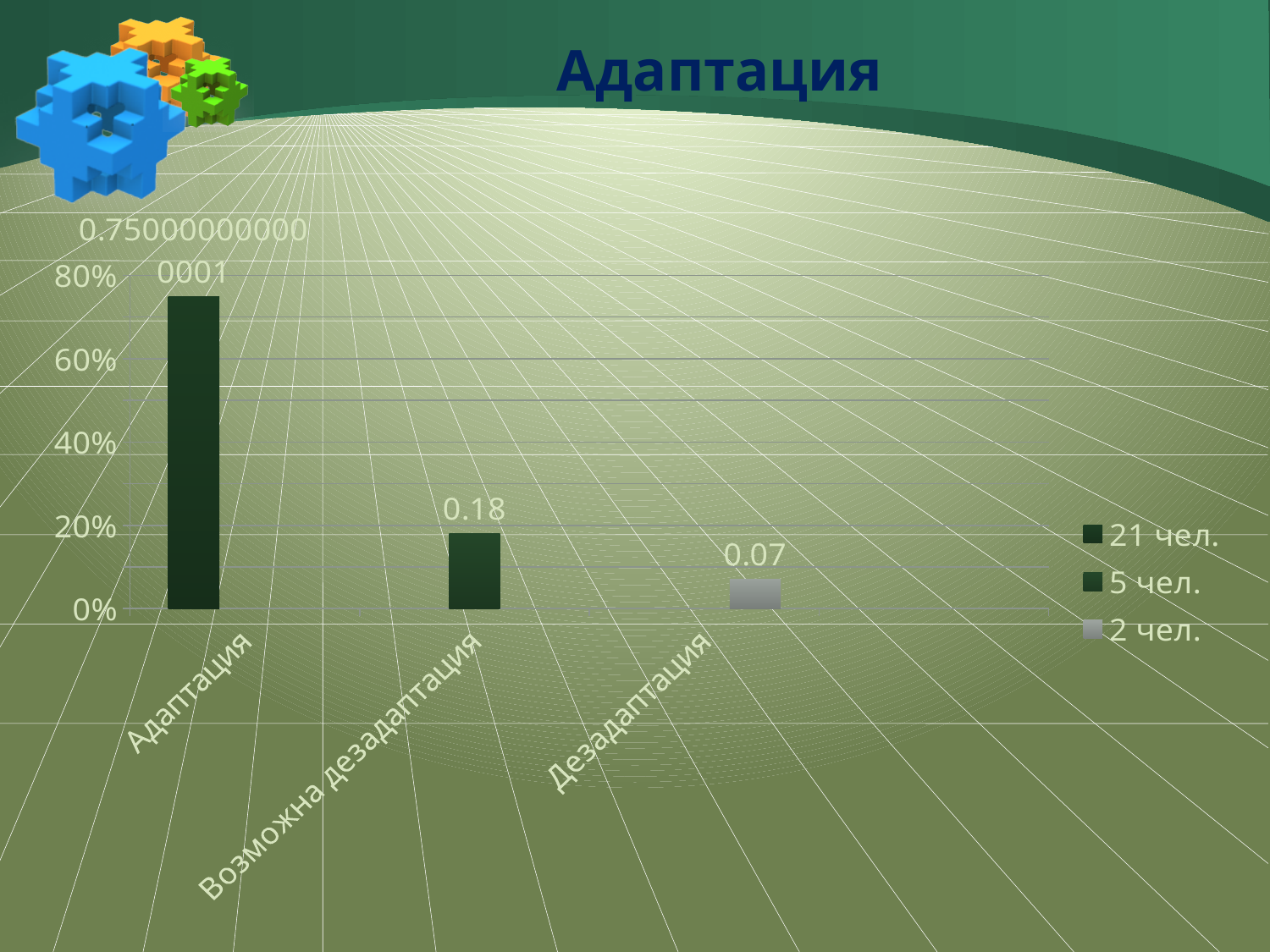
Which category has the highest bar? Адаптация How many entries does the chart's legend list? 3 Do the bar values rise or fall from left to right along the x axis? fall What kind of chart is shown on the slide? bar chart What is the difference between the data labels for Возможна дезадаптация and Дезадаптация? 0.11 How many categories are shown on the x axis of the chart? 3 Is the value for Адаптация greater or less than 60%? greater Which category has the lowest bar? Дезадаптация Which is larger, the value for Возможна дезадаптация or the value for Дезадаптация? Возможна дезадаптация What is the data label on the bar for Возможна дезадаптация? 0.18 What is the data label on the bar for Дезадаптация? 0.07 What is the title of the chart? Адаптация